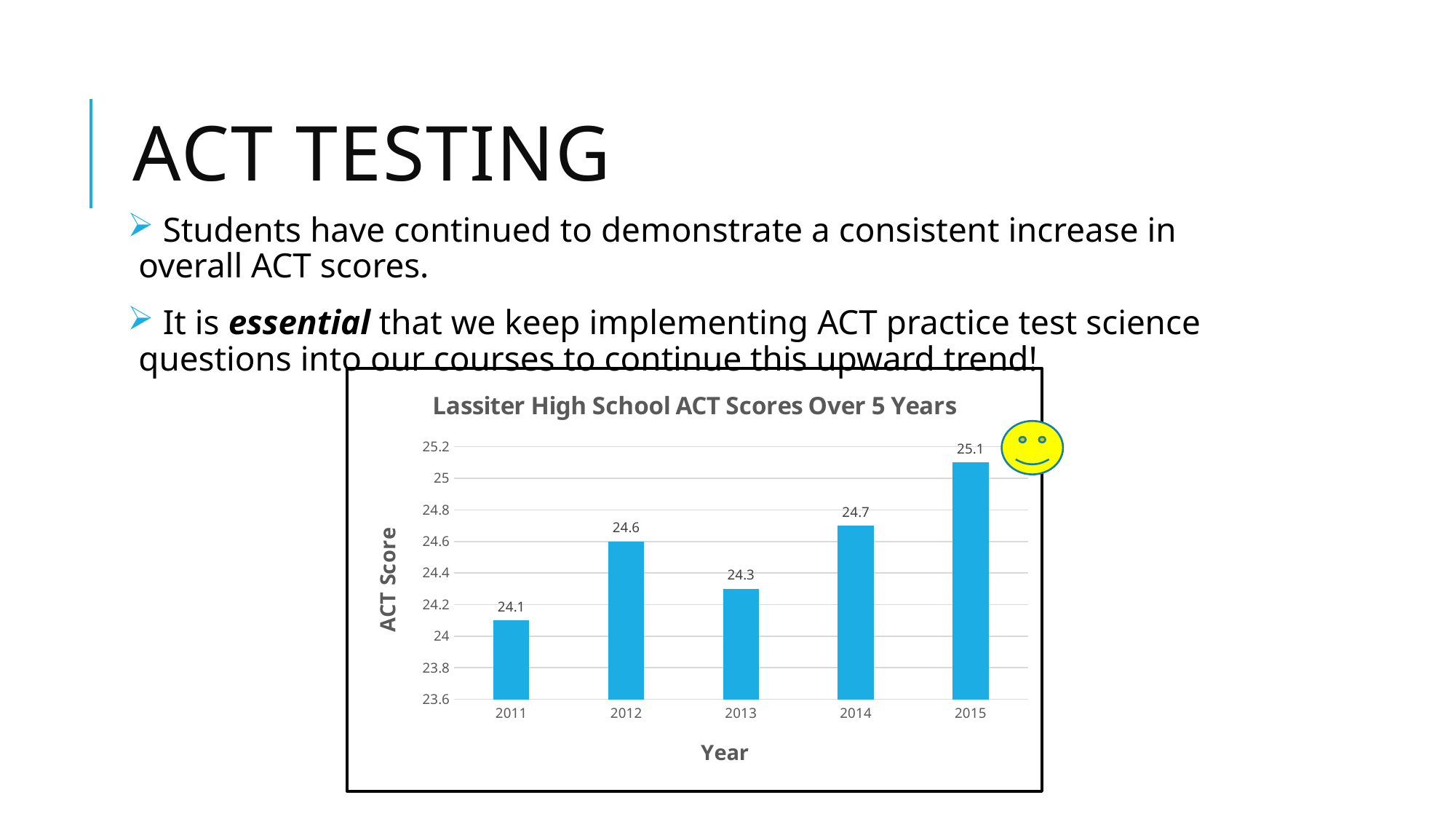
How many years are shown in the chart? 5 Which year has a higher ACT score, 2012 or 2013? 2012 What is the ACT score for 2015? 25.1 Is the ACT score for 2014 greater or less than 25? less What is the ACT score for 2011? 24.1 What is the ACT score for 2013? 24.3 What kind of chart is shown on the slide? bar chart What is the title of the chart? Lassiter High School ACT Scores Over 5 Years Which year has the highest ACT score? 2015 Which year has the lowest ACT score? 2011 What is the difference between the ACT scores for 2015 and 2011? 1.0 What is the difference between the ACT scores for 2012 and 2013? 0.3